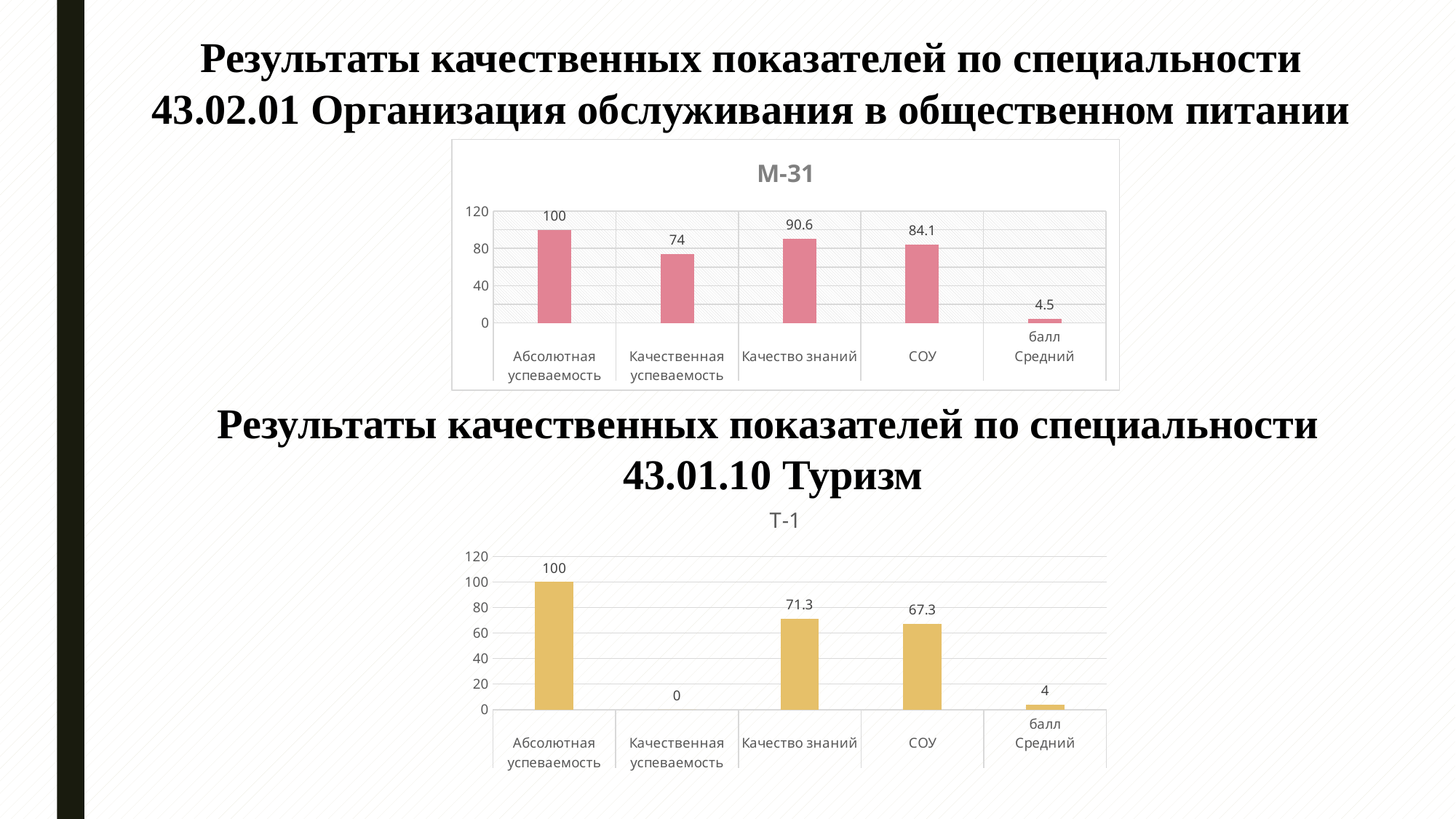
In the T-1 chart, which is larger: Качество знаний or СОУ? Качество знаний In the M-31 chart, what is the value for Качественная успеваемость? 74 In the T-1 chart, what is the difference between Абсолютная успеваемость and Качество знаний? 28.7 What type of chart is the T-1 chart? Bar chart In the M-31 chart, which category has the lowest value? Средний балл In the T-1 chart, what is the value for Качественная успеваемость? 0 In the M-31 chart, what is the value for Качество знаний? 90.6 In the M-31 chart, how many categories are shown? 5 In the M-31 chart, what is the difference between Качество знаний and СОУ? 6.5 What is the title of the upper chart? М-31 In the T-1 chart, which category has the highest value? Абсолютная успеваемость In the T-1 chart, what is the value for СОУ? 67.3